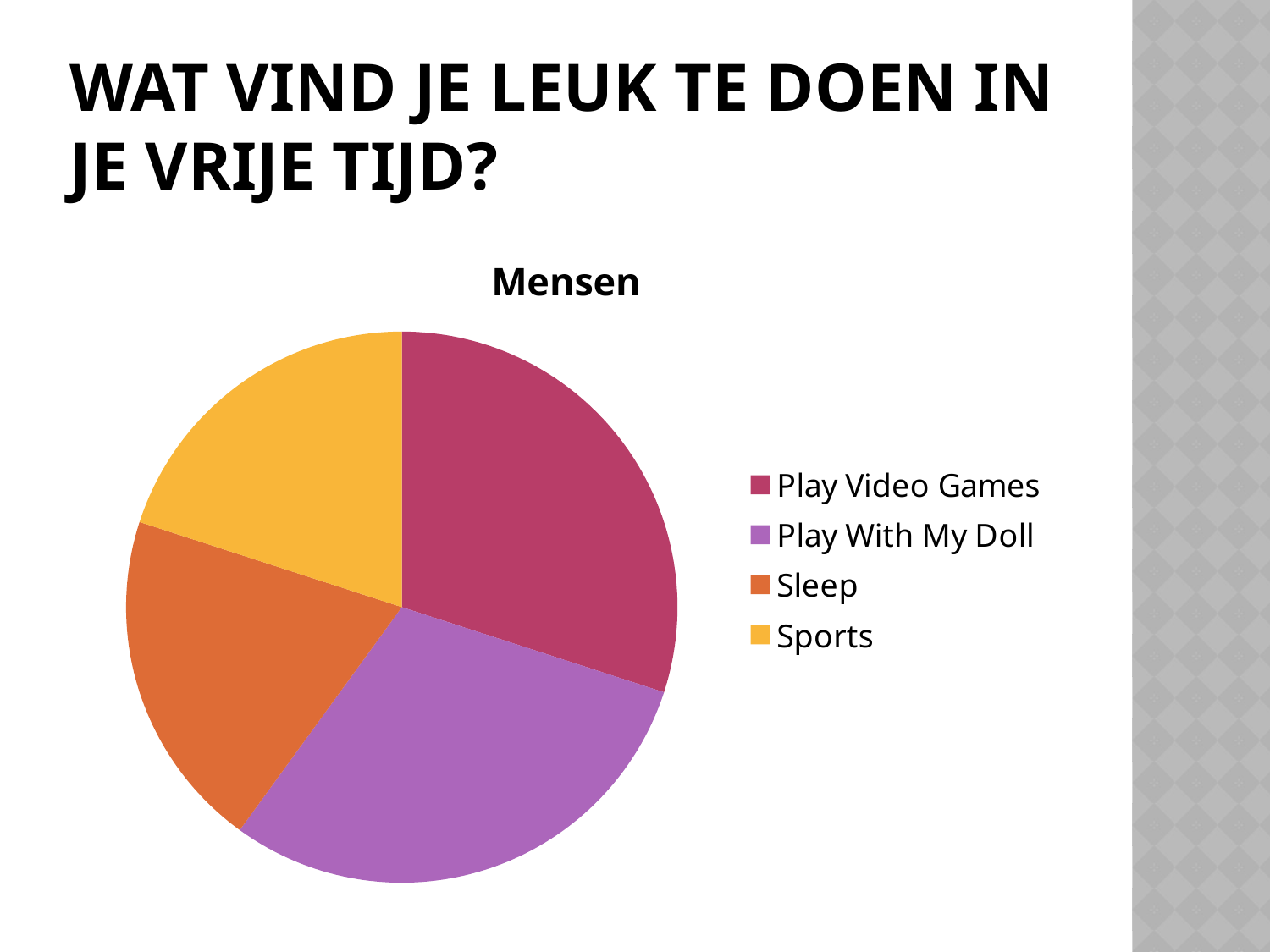
What kind of chart is shown on the slide? pie chart What is the title of the chart? Mensen Which category is shown in yellow in the pie chart? Sports Which slice is larger, Sleep or Play With My Doll? Play With My Doll Which slice is larger, Play With My Doll or Sports? Play With My Doll How many entries does the chart legend list? 4 Which slice is larger, Play Video Games or Sleep? Play Video Games How many categories (slices) does the pie chart have? 4